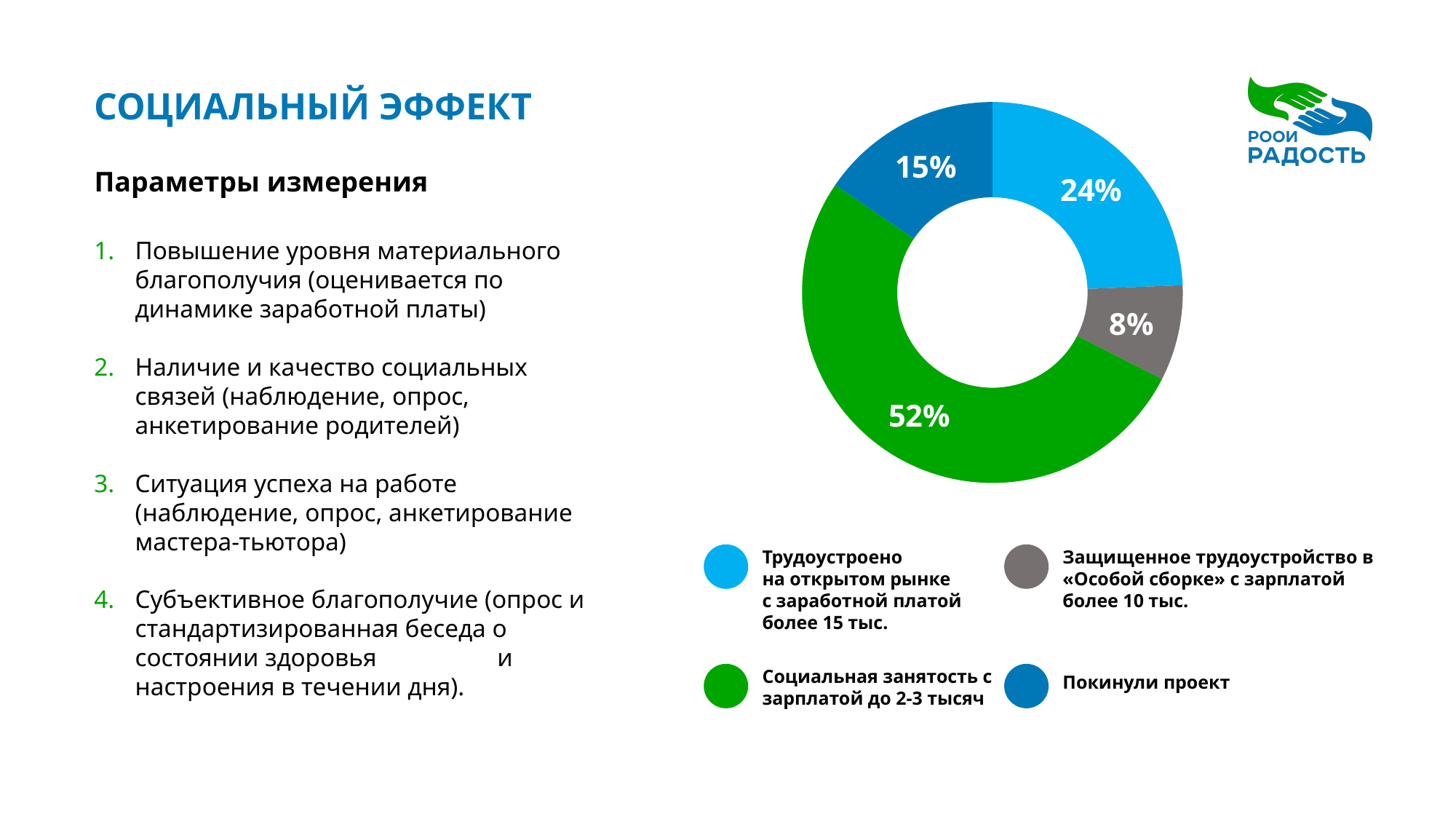
What is the difference in percentage points between the "Социальная занятость" slice and the "Трудоустроено на открытом рынке" slice? 28 Which category has the smallest slice of the pie chart? Защищенное трудоустройство в «Особой сборке» с зарплатой более 10 тыс. What percentage is shown for "Защищенное трудоустройство в «Особой сборке» с зарплатой более 10 тыс."? 8% What share of the pie chart is labelled "Социальная занятость с зарплатой до 2-3 тысяч"? 52% What percentage does the slice "Покинули проект" show? 15% What percentage is shown for "Трудоустроено на открытом рынке с заработной платой более 15 тыс."? 24% What colour is the slice for "Социальная занятость с зарплатой до 2-3 тысяч"? Green Which is larger: the "Покинули проект" slice or the "Защищенное трудоустройство" slice? Покинули проект How many entries does the legend of the pie chart list? 4 Which category has the largest slice of the pie chart? Социальная занятость с зарплатой до 2-3 тысяч How many slices does the pie chart have? 4 What kind of chart is shown on the slide? Pie chart (donut)